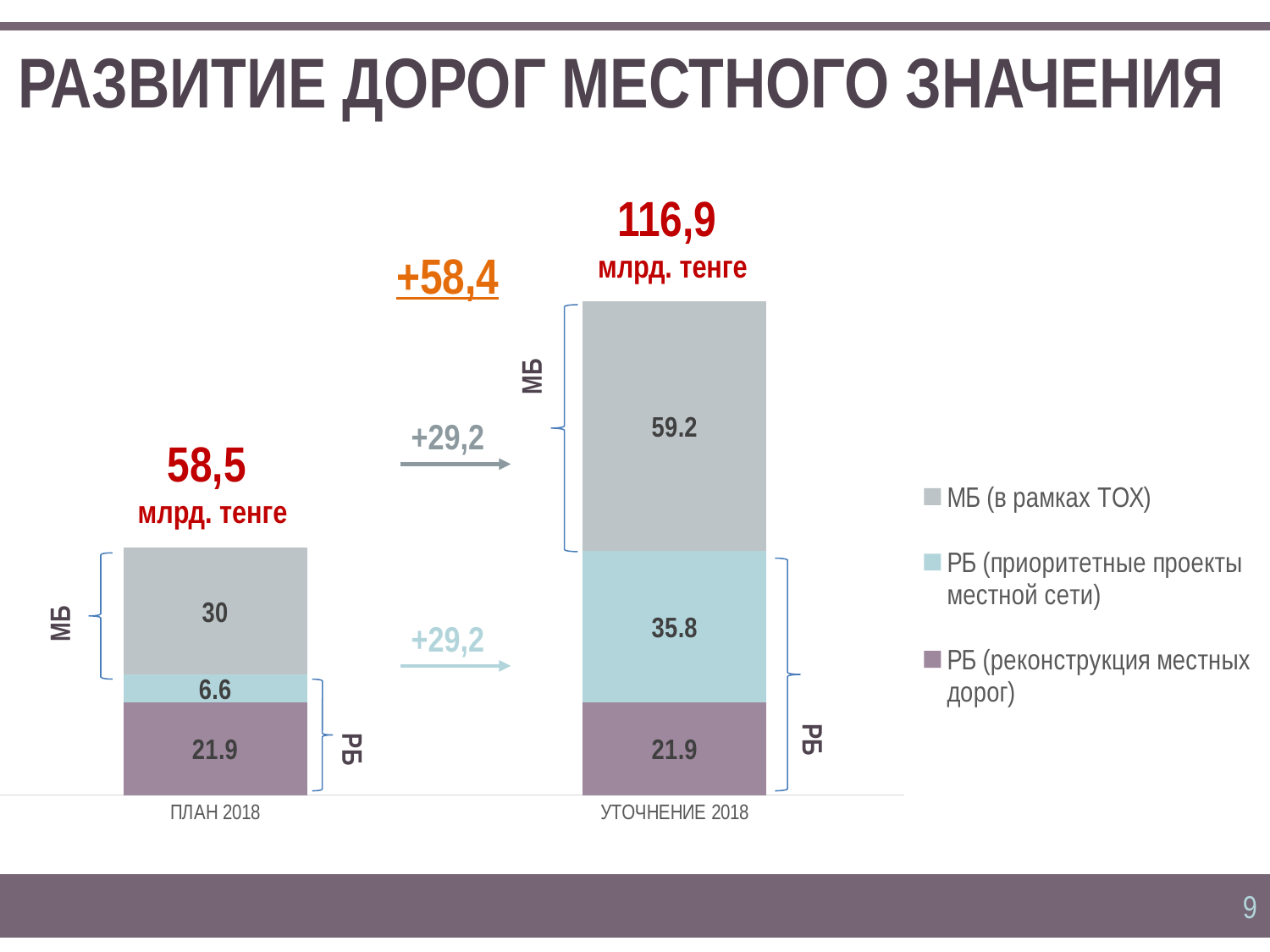
What is the total of the stacked bar for УТОЧНЕНИЕ 2018, as labelled on the slide? 116,9 млрд. тенге What is the value of РБ (реконструкция местных дорог) for ПЛАН 2018? 21.9 What is the value of МБ (в рамках ТОХ) for ПЛАН 2018? 30 Which series has the highest value in the УТОЧНЕНИЕ 2018 bar? МБ (в рамках ТОХ) Which is larger: РБ (приоритетные проекты местной сети) for ПЛАН 2018 or for УТОЧНЕНИЕ 2018? УТОЧНЕНИЕ 2018 Which series has the lowest value in the ПЛАН 2018 bar? РБ (приоритетные проекты местной сети) What is the value of РБ (приоритетные проекты местной сети) for УТОЧНЕНИЕ 2018? 35.8 What is the total of the stacked bar for ПЛАН 2018, as labelled on the slide? 58,5 млрд. тенге What kind of chart is shown on the slide? Stacked bar chart What is the value of МБ (в рамках ТОХ) for УТОЧНЕНИЕ 2018? 59.2 What is the difference between the МБ (в рамках ТОХ) values for УТОЧНЕНИЕ 2018 and ПЛАН 2018? 29.2 How many series does the legend list? 3